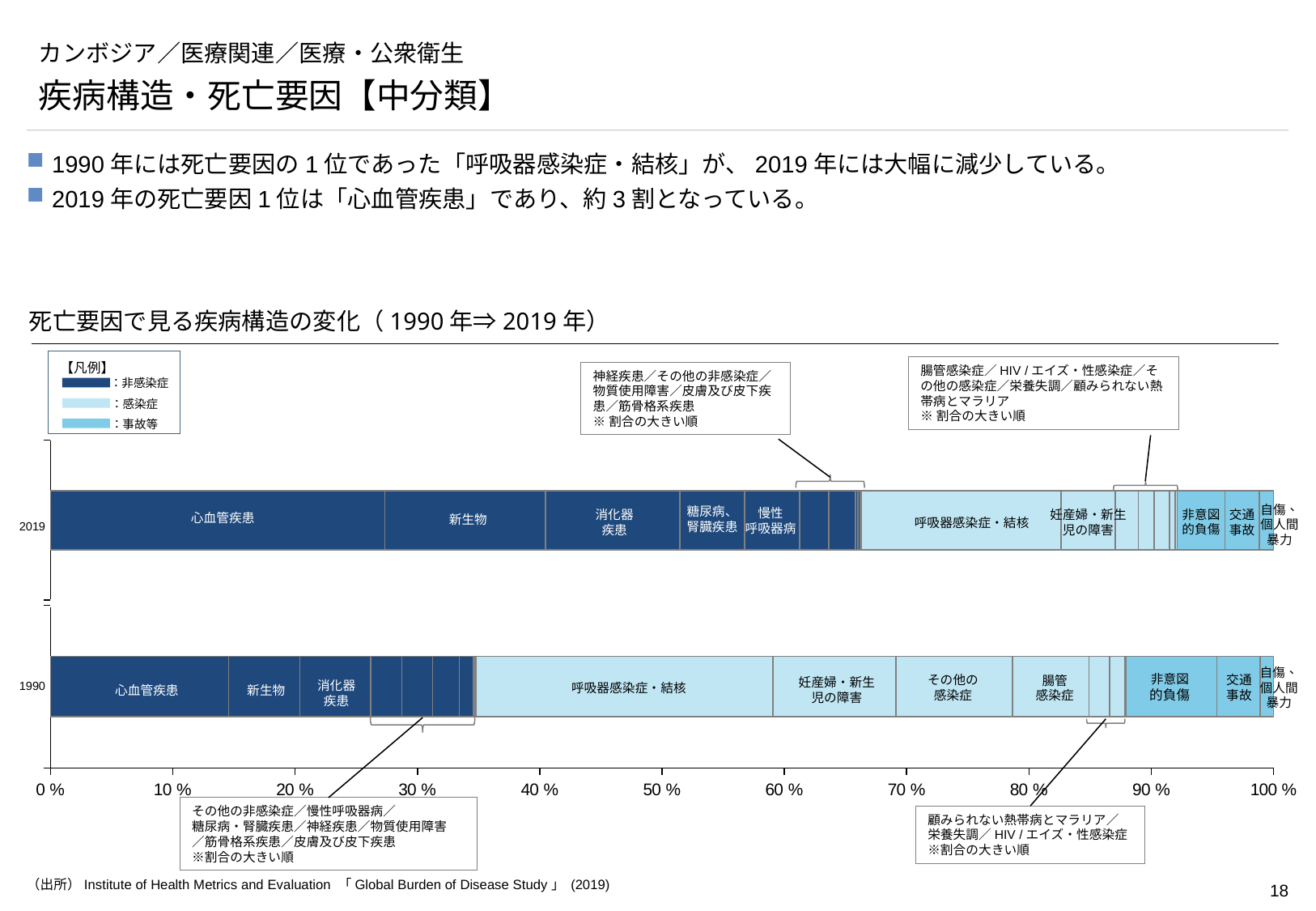
Which legend category is shown in the darkest blue? 非感染症 Did the share of 心血管疾患 rise or fall from 1990 to 2019? rise How many bars (years) does the chart compare? 2 Is the share of 心血管疾患 in the 2019 bar greater or less than 20%? greater Which segment is the largest in the 2019 bar? 心血管疾患 Which segment is the largest in the 1990 bar? 呼吸器感染症・結核 In the 2019 bar, which is larger: 心血管疾患 or 新生物? 心血管疾患 Is the share of 心血管疾患 in the 1990 bar greater or less than 20%? less How many categories does the legend (凡例) list? 3 Is the share of 呼吸器感染症・結核 in the 1990 bar greater or less than 20%? greater What kind of chart is shown on the slide? Stacked bar chart In the 1990 bar, which is larger: 呼吸器感染症・結核 or 心血管疾患? 呼吸器感染症・結核